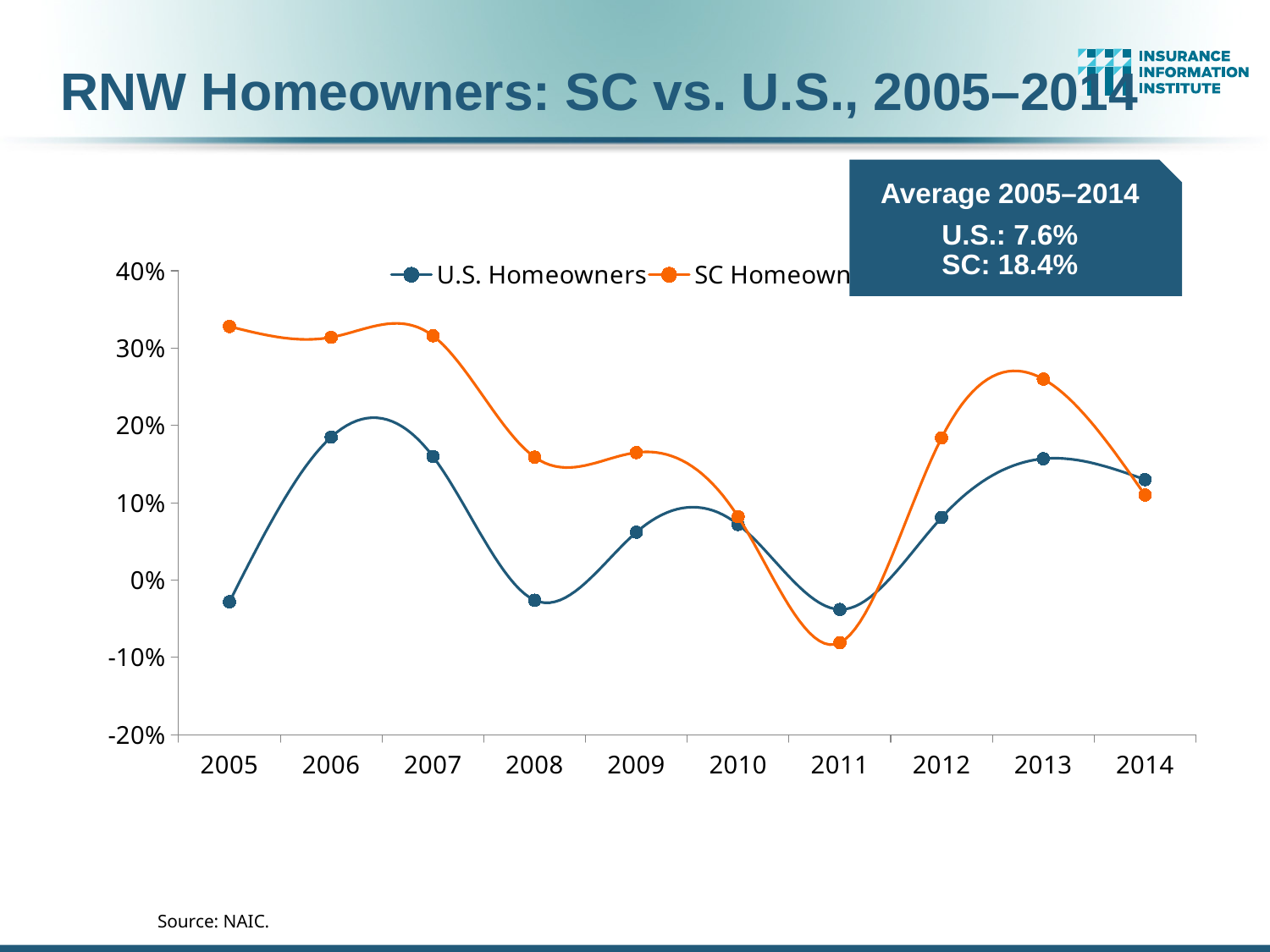
In which year is the SC Homeowners value lowest? 2011 What kind of chart is shown on the slide? line chart Is the value for SC Homeowners in 2011 greater or less than 0%? less Is the value for U.S. Homeowners in 2006 greater or less than 10%? greater In which year is the U.S. Homeowners value highest? 2006 How many years are plotted along the x axis? 10 How many series does the legend list? 2 Is the value for SC Homeowners in 2005 greater or less than 30%? greater What is the average RNW for SC homeowners over 2005–2014, as printed in the box? 18.4% Which series has the larger value in 2012, U.S. Homeowners or SC Homeowners? SC Homeowners What is the average RNW for U.S. homeowners over 2005–2014, as printed in the box? 7.6% Do the SC Homeowners values rise or fall from 2007 to 2011? fall